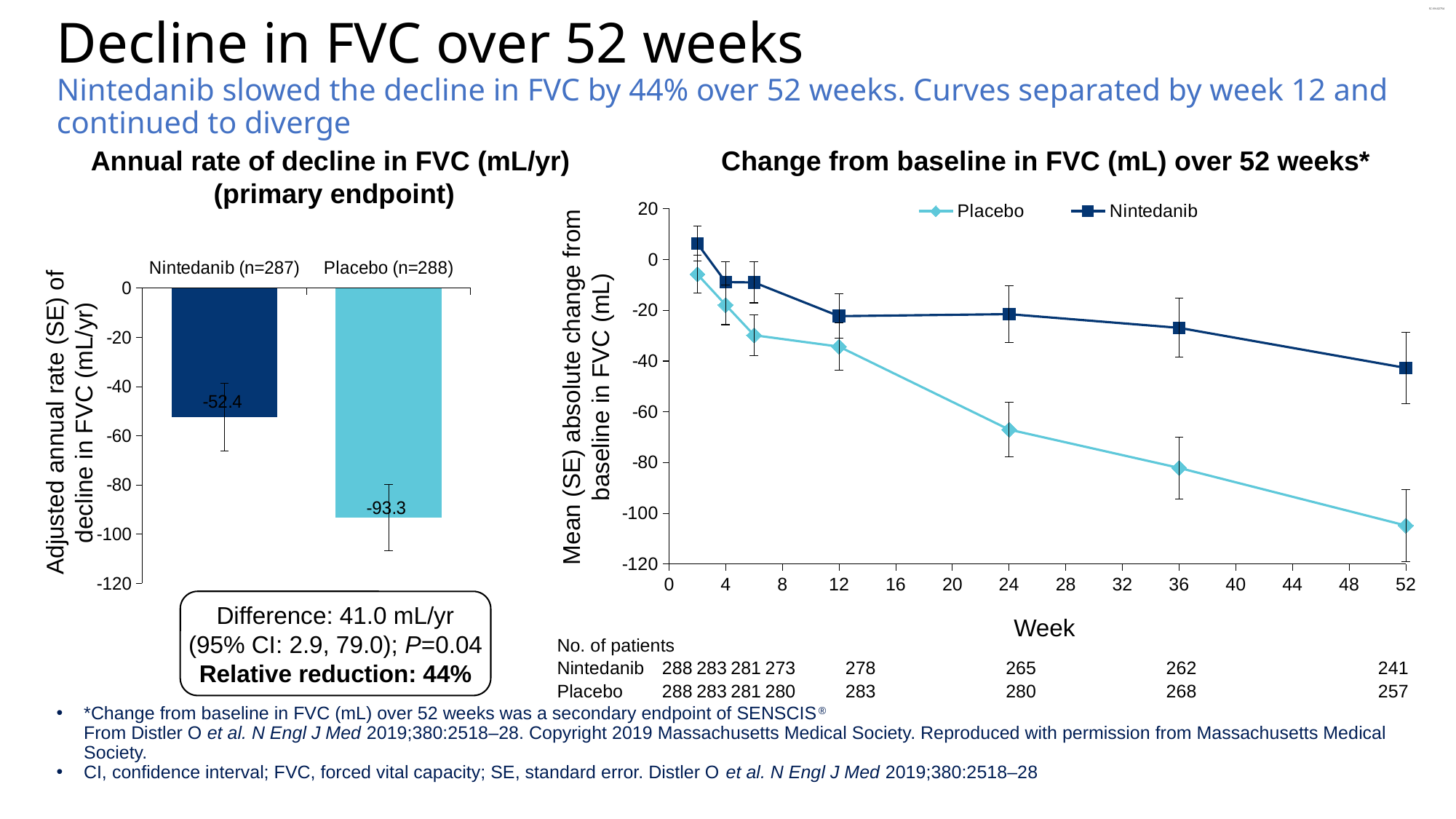
What kind of chart is the 'Change from baseline in FVC (mL) over 52 weeks' chart? Line chart In the 'Change from baseline in FVC (mL) over 52 weeks' chart, is the Nintedanib value at week 52 greater or less than -60? greater In the 'Change from baseline in FVC (mL) over 52 weeks' chart, which series has the lower value at week 36? Placebo In the 'Annual rate of decline in FVC (mL/yr)' chart, what is the value for Nintedanib? -52.4 In the 'Annual rate of decline in FVC (mL/yr)' chart, what is the difference between the Placebo and Nintedanib values? 40.9 In the 'Change from baseline in FVC (mL) over 52 weeks' chart, is the Placebo value at week 52 greater or less than -100? less In the 'Annual rate of decline in FVC (mL/yr)' chart, which group shows the larger decline in FVC? Placebo What kind of chart is the 'Annual rate of decline in FVC (mL/yr)' chart? Bar chart How many series does the legend list in the 'Change from baseline in FVC (mL) over 52 weeks' chart? 2 How many bars are shown in the 'Annual rate of decline in FVC (mL/yr)' chart? 2 In the 'Annual rate of decline in FVC (mL/yr)' chart, what is the value for Placebo? -93.3 In the 'Change from baseline in FVC (mL) over 52 weeks' chart, do the Placebo values rise or fall from week 0 to week 52? Fall